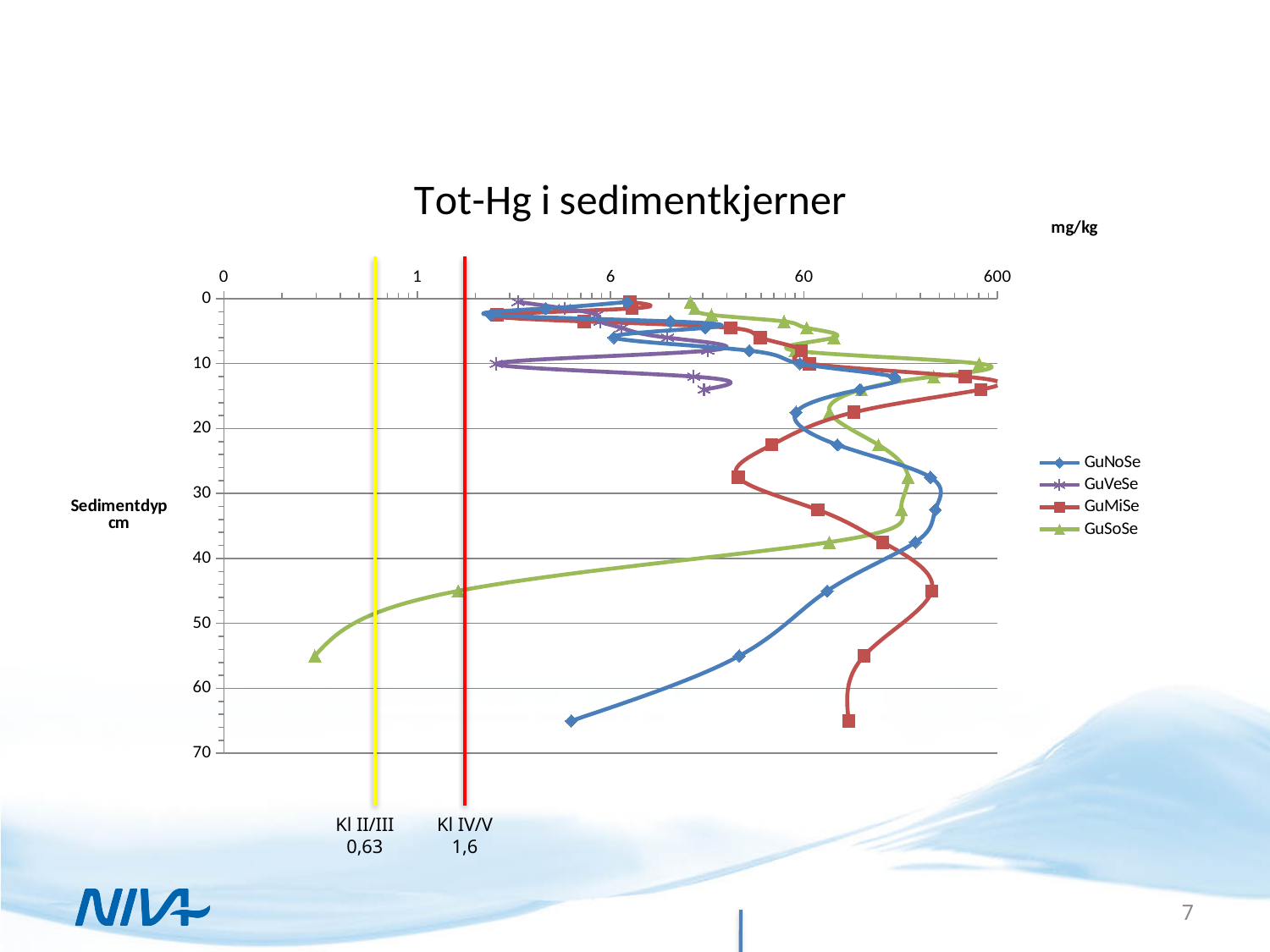
What is the title of the chart? Tot-Hg i sedimentkjerner Which series' data stops at the shallowest depth? GuVeSe What kind of chart is shown on the slide? line chart How many series does the legend list? 4 At 65 cm depth, which series has the higher value, GuMiSe or GuNoSe? GuMiSe Is the value for GuMiSe at 65 cm depth greater or less than 60? greater At what concentration is the yellow Kl II/III reference line drawn? 0,63 Is the value for GuNoSe at 55 cm depth greater or less than 6? greater At what concentration is the red Kl IV/V reference line drawn? 1,6 Is the value for GuSoSe at 55 cm depth greater or less than 1? less What unit is shown for the x axis of the chart? mg/kg